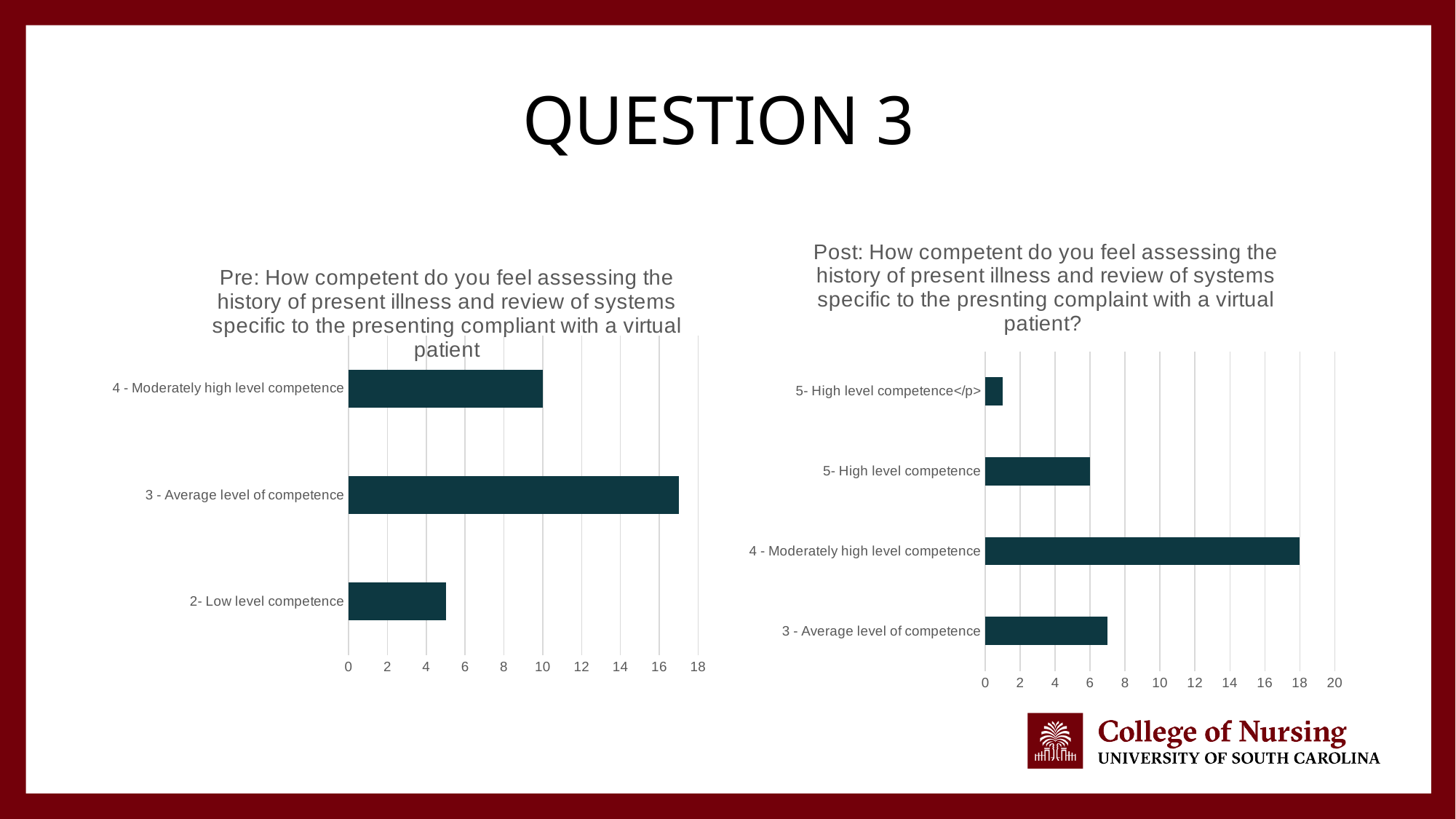
On the Pre chart (left), which category has the highest value? 3 - Average level of competence On the Pre chart (left), which category has the lowest value? 2- Low level competence On the Pre chart (left), is the value for "2- Low level competence" greater or less than 6? less On the Pre chart (left), is the value for "3 - Average level of competence" greater or less than 16? greater On the Post chart (right), what is the value for "5- High level competence"? 6 On the Post chart (right), which category has the highest value? 4 - Moderately high level competence How many categories are shown on the Post chart (right)? 4 On the Post chart (right), what is the value for "4 - Moderately high level competence"? 18 On the Pre chart (left), what is the value for "4 - Moderately high level competence"? 10 On the Post chart (right), which category has the lowest value? 5- High level competence</p> What type of chart is the Pre chart (left)? Bar chart On the Post chart (right), is the value for "3 - Average level of competence" greater or less than 6? greater